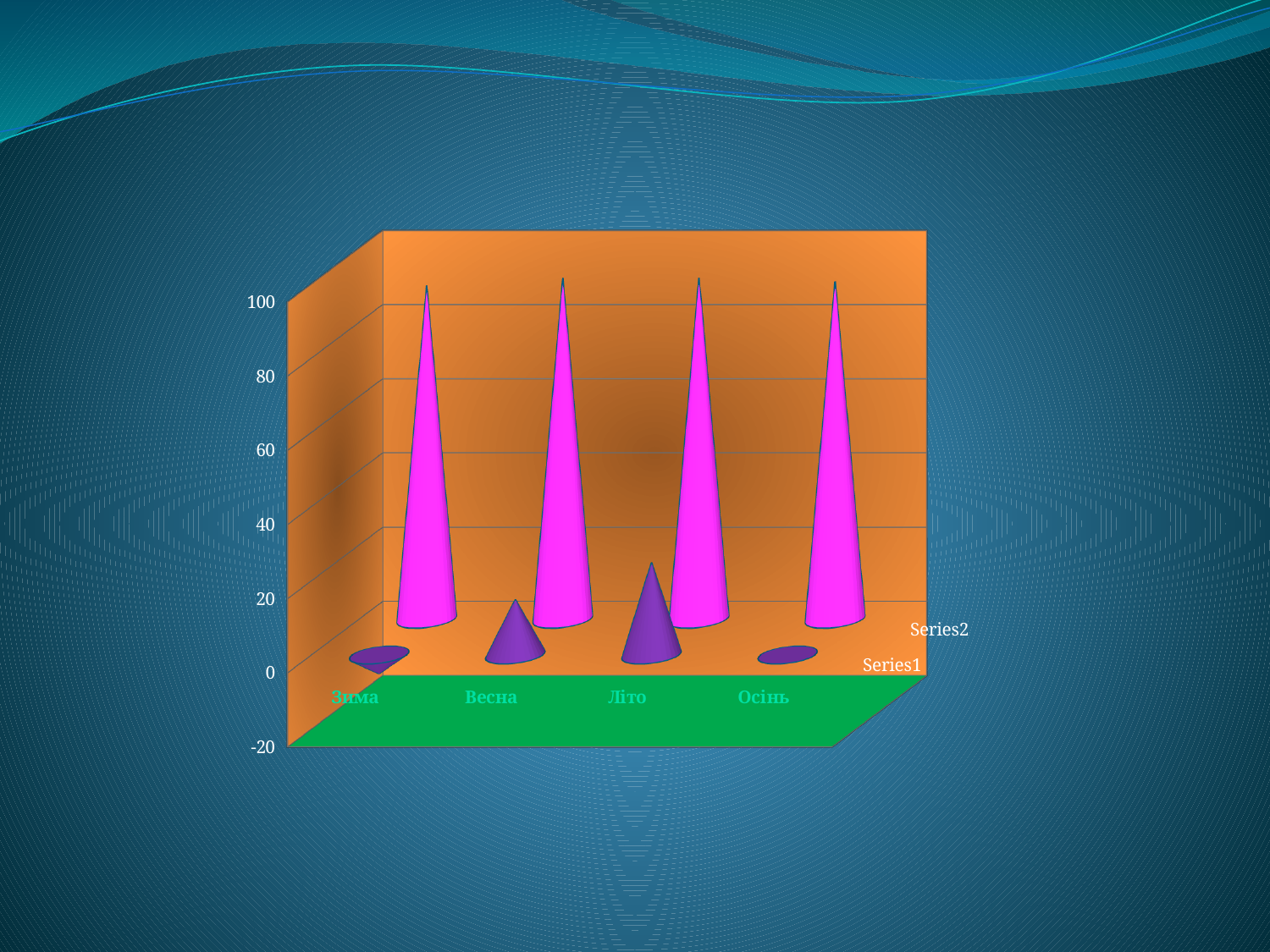
What is the lowest value shown on the vertical axis of the chart? -20 Is the Series1 value for Літо greater or less than 40? less Is the Series2 value for Зима greater or less than 80? greater What are the category labels along the x axis of the chart? Зима, Весна, Літо, Осінь Is the Series1 value for Весна greater or less than 60? less For Series1, which is larger: the value for Весна or the value for Літо? Літо How many categories are shown on the x axis of the chart? 4 Which category has the highest Series1 value? Літо What kind of chart is shown on the slide? bar chart How many series does the chart show? 2 For Зима, which series has the larger value: Series1 or Series2? Series2